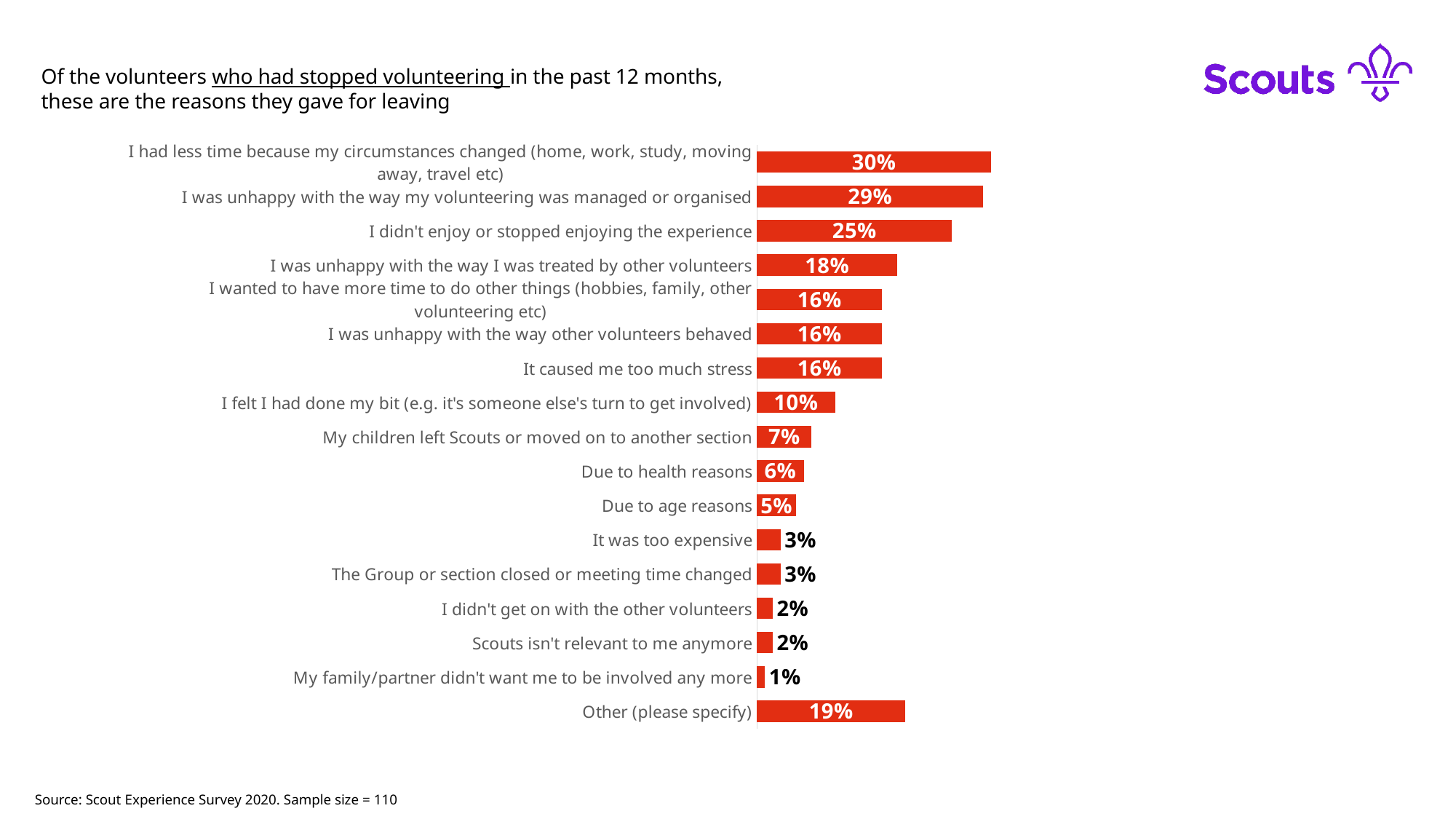
How many reasons for leaving are listed in the chart? 17 What kind of chart is shown on the slide? Bar chart Which reason for leaving has the highest percentage? I had less time because my circumstances changed (home, work, study, moving away, travel etc) What percentage gave 'Due to health reasons' as a reason for leaving? 6% What percentage of volunteers who stopped said they had less time because their circumstances changed? 30% What percentage said they were unhappy with the way they were treated by other volunteers? 18% Which reason for leaving has the lowest percentage? My family/partner didn't want me to be involved any more What is the difference in percentage points between 'I was unhappy with the way my volunteering was managed or organised' and 'I didn't enjoy or stopped enjoying the experience'? 4 What percentage selected 'Other (please specify)'? 19% Which is larger: the percentage for 'It caused me too much stress' or for 'I felt I had done my bit'? It caused me too much stress What colour are the bars in the chart? Red What is the sample size stated in the source note? 110